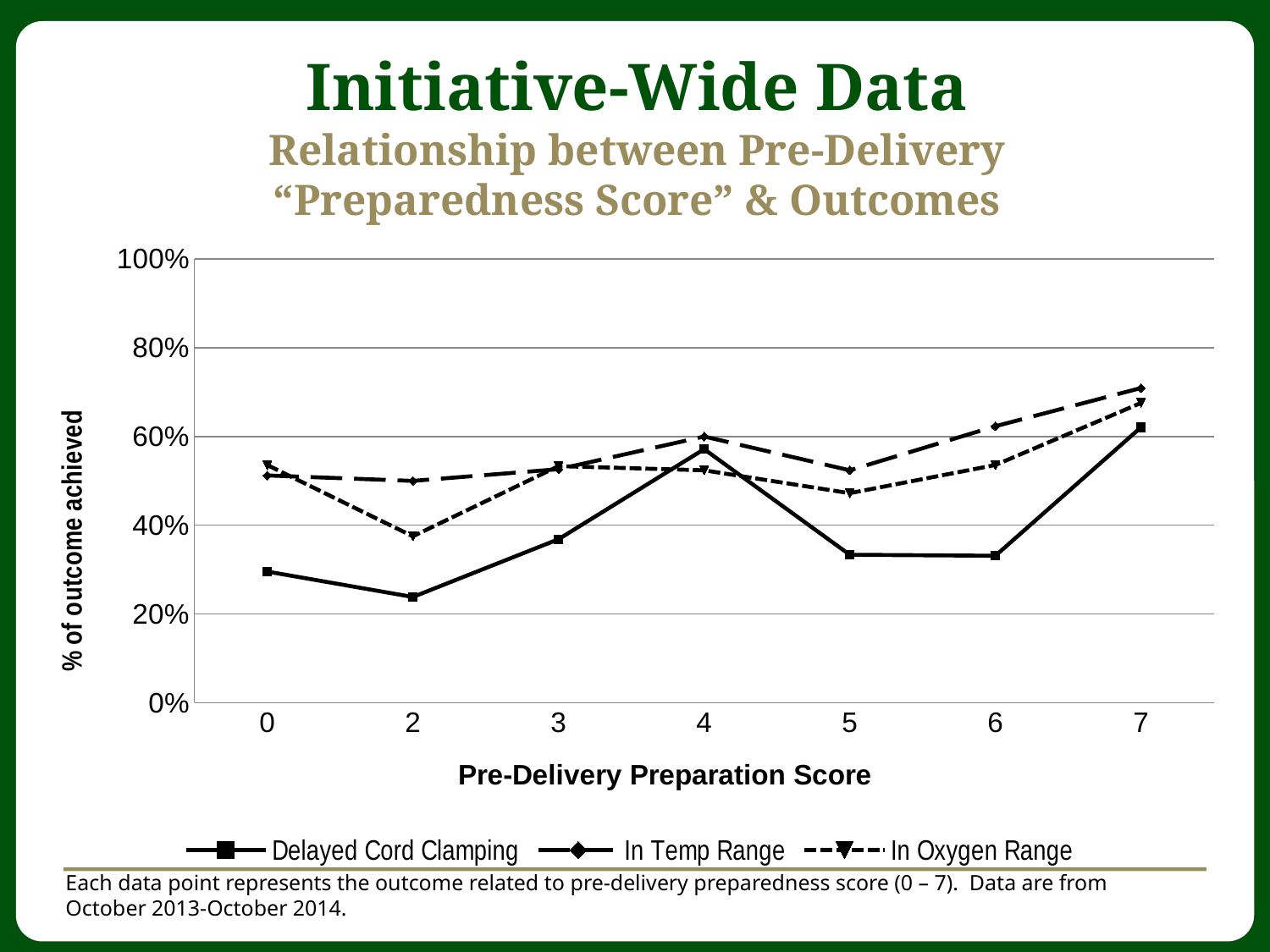
How many series does the legend list? 3 At score 2, which is larger: In Temp Range or In Oxygen Range? In Temp Range At which Pre-Delivery Preparation Score is the In Temp Range value highest? 7 Is the In Temp Range value at score 7 greater or less than 60%? greater Which series is drawn with a dashed line and triangle markers? In Oxygen Range Is the Delayed Cord Clamping value at score 2 greater or less than 40%? less Does the Delayed Cord Clamping line rise or fall from score 6 to score 7? rise At which Pre-Delivery Preparation Score is the Delayed Cord Clamping value lowest? 2 Is the In Oxygen Range value at score 5 greater or less than 60%? less What is the label of the y axis? % of outcome achieved How many Pre-Delivery Preparation Score values are plotted along the x axis? 7 What kind of chart is shown on the slide? Line chart